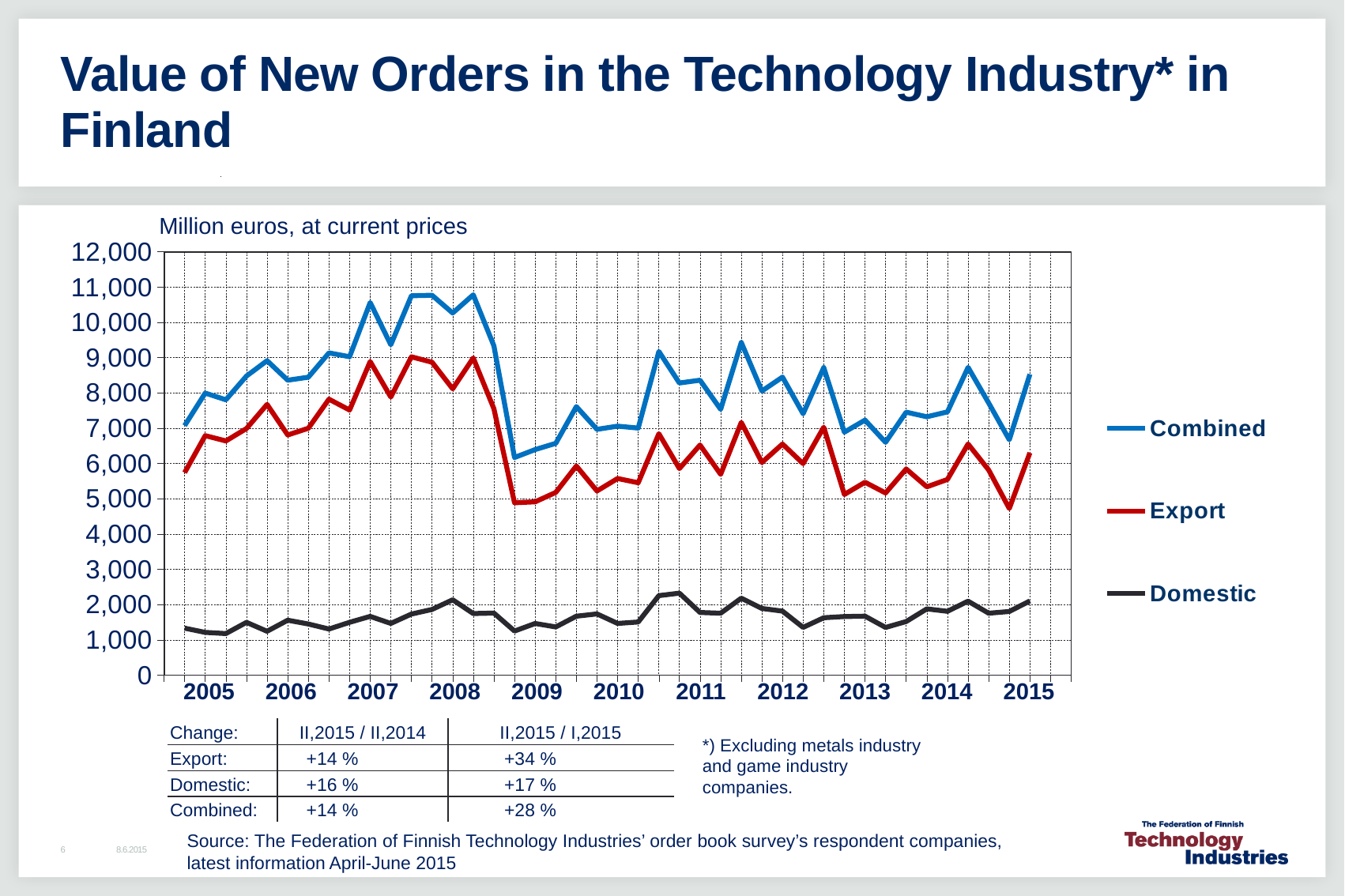
Which series has the lowest values throughout the chart? Domestic How many years are labelled on the x axis? 11 Does the Combined series rise or fall between 2008 and 2009? Fall Is the peak value of the Combined series around 2007-2008 greater or less than 10,000? greater What kind of chart is shown on the slide? Line chart Which series has the highest values throughout the chart? Combined How many series does the legend list? 3 Is the Combined value at the start of 2005 greater or less than 6,000? greater What unit is stated above the chart for the values? Million euros, at current prices Which is larger in 2015, the Export value or the Domestic value? Export Is the highest value of the Domestic series greater or less than 3,000? less